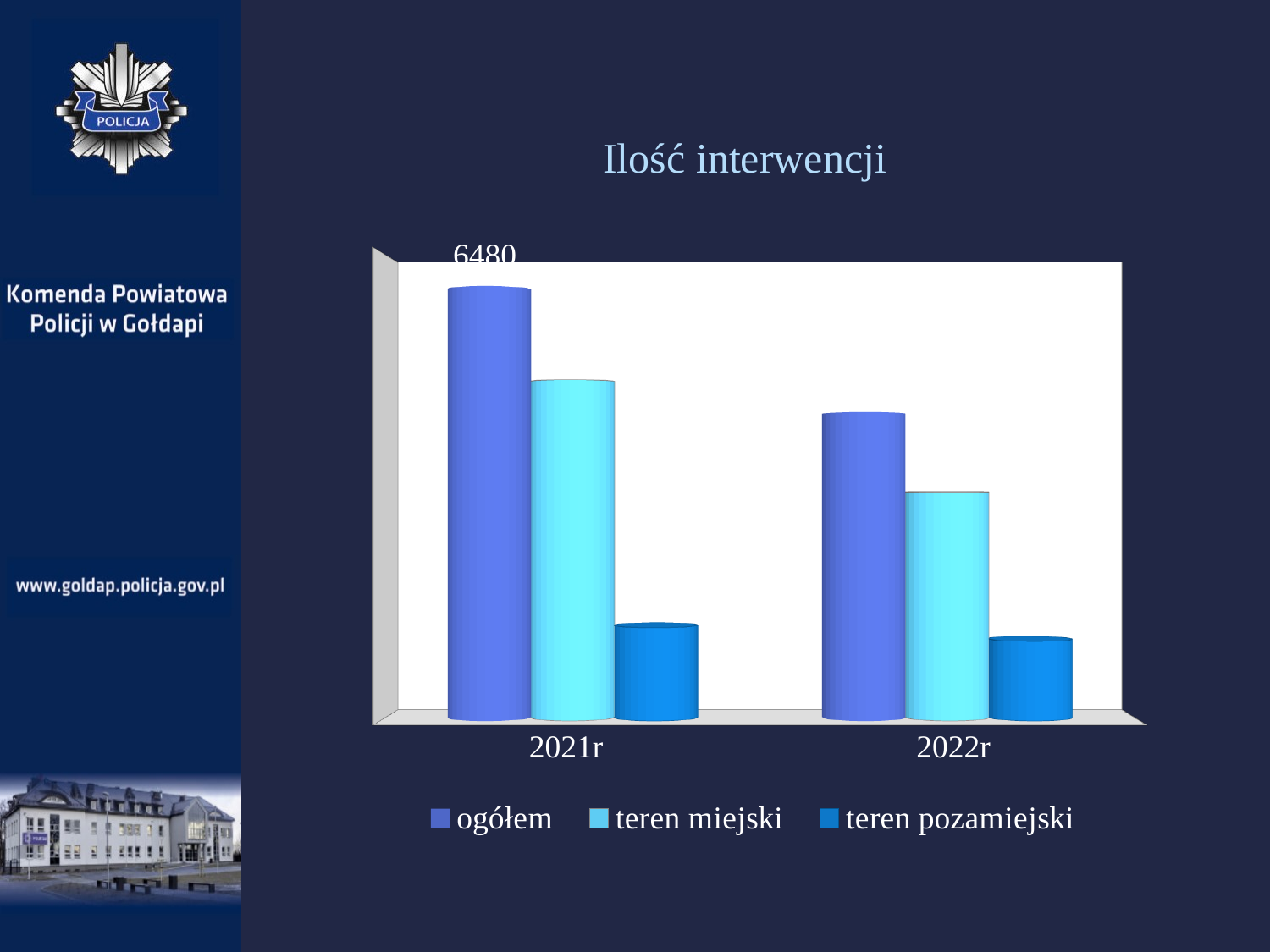
Which series has the tallest bar in the chart? ogółem How many year categories are shown on the x axis? 2 Is the teren miejski bar higher for 2021r or for 2022r? 2021r Which series has the shortest bar for 2022r? teren pozamiejski Which year has the higher ogółem value, 2021r or 2022r? 2021r What is the title of the chart? Ilość interwencji What is the value of the ogółem bar for 2021r? 6480 Does the ogółem value rise or fall from 2021r to 2022r? fall What kind of chart is shown on the slide? bar chart How many series does the legend list? 3 For 2021r, which is larger: teren miejski or teren pozamiejski? teren miejski Which series is shown in the lightest blue colour in the legend? teren miejski